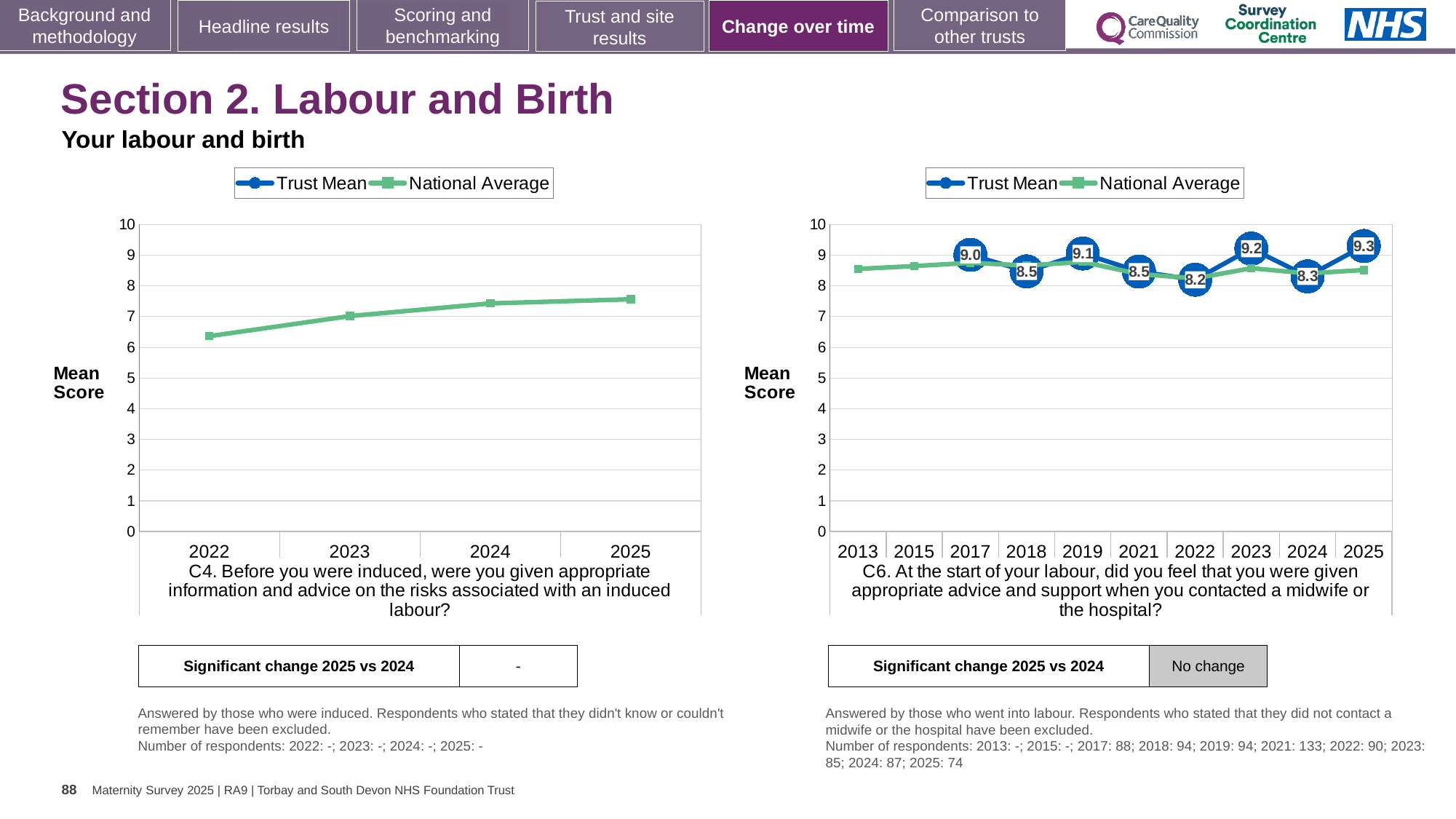
In the C6 chart on the right, which year has the lowest Trust Mean? 2022 How many series does the legend of the C4 chart on the left list? 2 In the C6 chart on the right, what is the Trust Mean for 2017? 9.0 In the C4 chart on the left, is the National Average for 2022 greater or less than 7? less In the C6 chart on the right, what is the Trust Mean for 2022? 8.2 In the C6 chart on the right, what is the Trust Mean for 2025? 9.3 In the C6 chart on the right, which year has the highest Trust Mean? 2025 In the C6 chart on the right, how many years are shown on the x axis? 10 In the C4 chart on the left, does the National Average rise or fall from 2022 to 2025? rise In the C6 chart on the right, what is the difference between the Trust Mean for 2025 and the Trust Mean for 2024? 1.0 In the C4 chart on the left, is the National Average for 2025 greater or less than 7? greater In the C6 chart on the right, is the Trust Mean higher in 2023 or in 2018? 2023